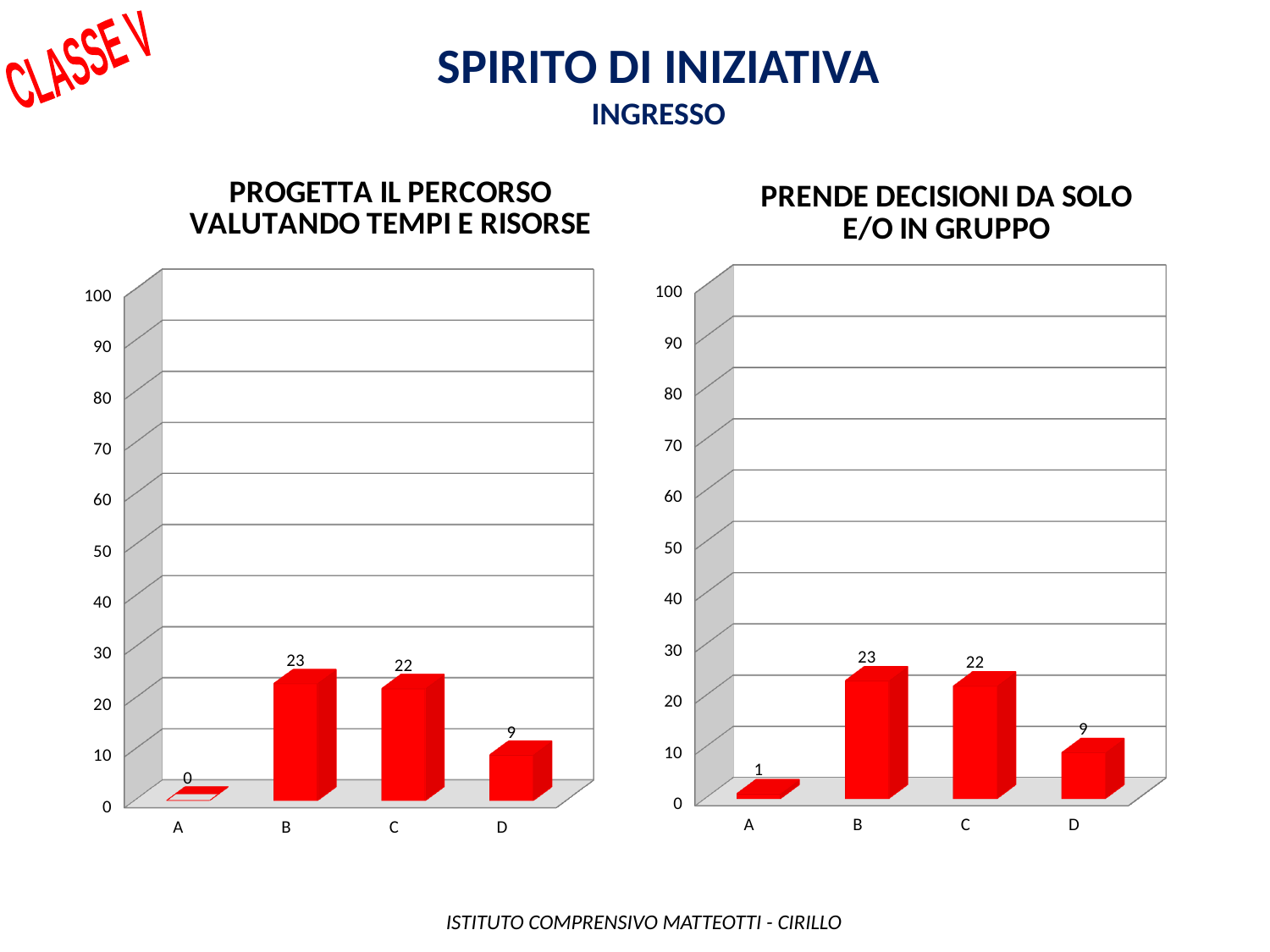
In the chart titled 'PROGETTA IL PERCORSO VALUTANDO TEMPI E RISORSE', what is the value for category A? 0 In the chart titled 'PRENDE DECISIONI DA SOLO E/O IN GRUPPO', what is the value for category D? 9 How many categories are shown in the chart titled 'PROGETTA IL PERCORSO VALUTANDO TEMPI E RISORSE'? 4 In the chart titled 'PROGETTA IL PERCORSO VALUTANDO TEMPI E RISORSE', what is the difference between the values for C and D? 13 What kind of chart is the chart titled 'PRENDE DECISIONI DA SOLO E/O IN GRUPPO'? Bar chart In the chart titled 'PRENDE DECISIONI DA SOLO E/O IN GRUPPO', which is larger, the value for B or the value for D? B In the chart titled 'PRENDE DECISIONI DA SOLO E/O IN GRUPPO', which category has the lowest value? A In the chart titled 'PROGETTA IL PERCORSO VALUTANDO TEMPI E RISORSE', which category has the highest value? B In the chart titled 'PROGETTA IL PERCORSO VALUTANDO TEMPI E RISORSE', what is the value for category B? 23 In the chart titled 'PRENDE DECISIONI DA SOLO E/O IN GRUPPO', is the value for C greater or less than 30? less What is the title of the chart on the left side of the slide? PROGETTA IL PERCORSO VALUTANDO TEMPI E RISORSE In the chart titled 'PRENDE DECISIONI DA SOLO E/O IN GRUPPO', what is the value for category A? 1